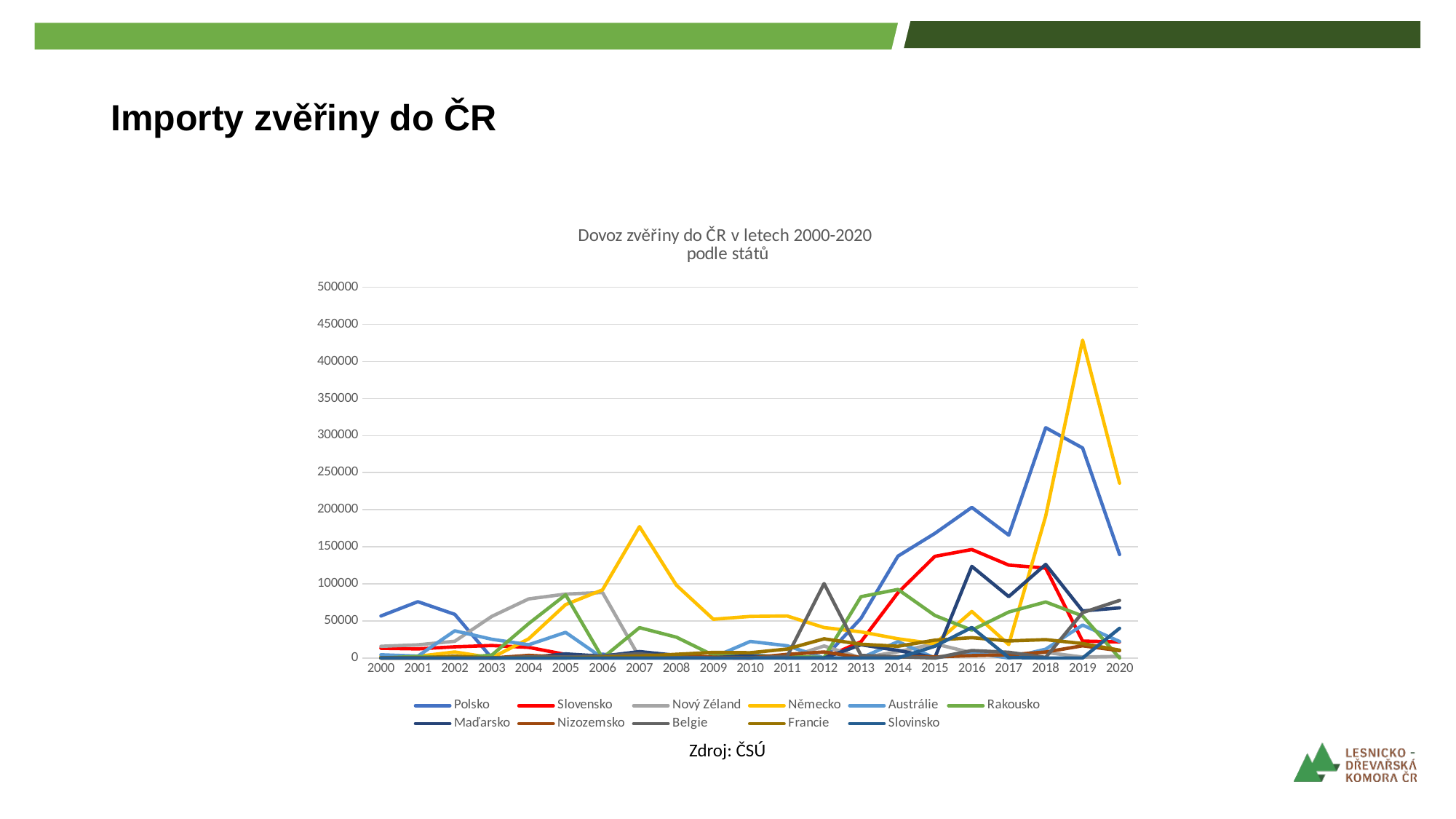
In 2016, which is larger: the value for Polsko or the value for Slovensko? Polsko In which year does the Polsko series reach its highest value? 2018 How many years are shown along the x axis of the chart? 21 Which series reaches the highest value anywhere in the chart? Německo Is the value for Německo in 2007 greater or less than 150000? greater In which year does the Německo series reach its peak? 2019 Is the value for Polsko in 2018 greater or less than 250000? greater What kind of chart is shown on the slide? line chart In 2020, which is larger: the value for Německo or the value for Polsko? Německo How many series does the legend of the chart list? 11 What is the title of the chart? Dovoz zvěřiny do ČR v letech 2000-2020 podle států Is the value for Německo in 2019 greater or less than 400000? greater